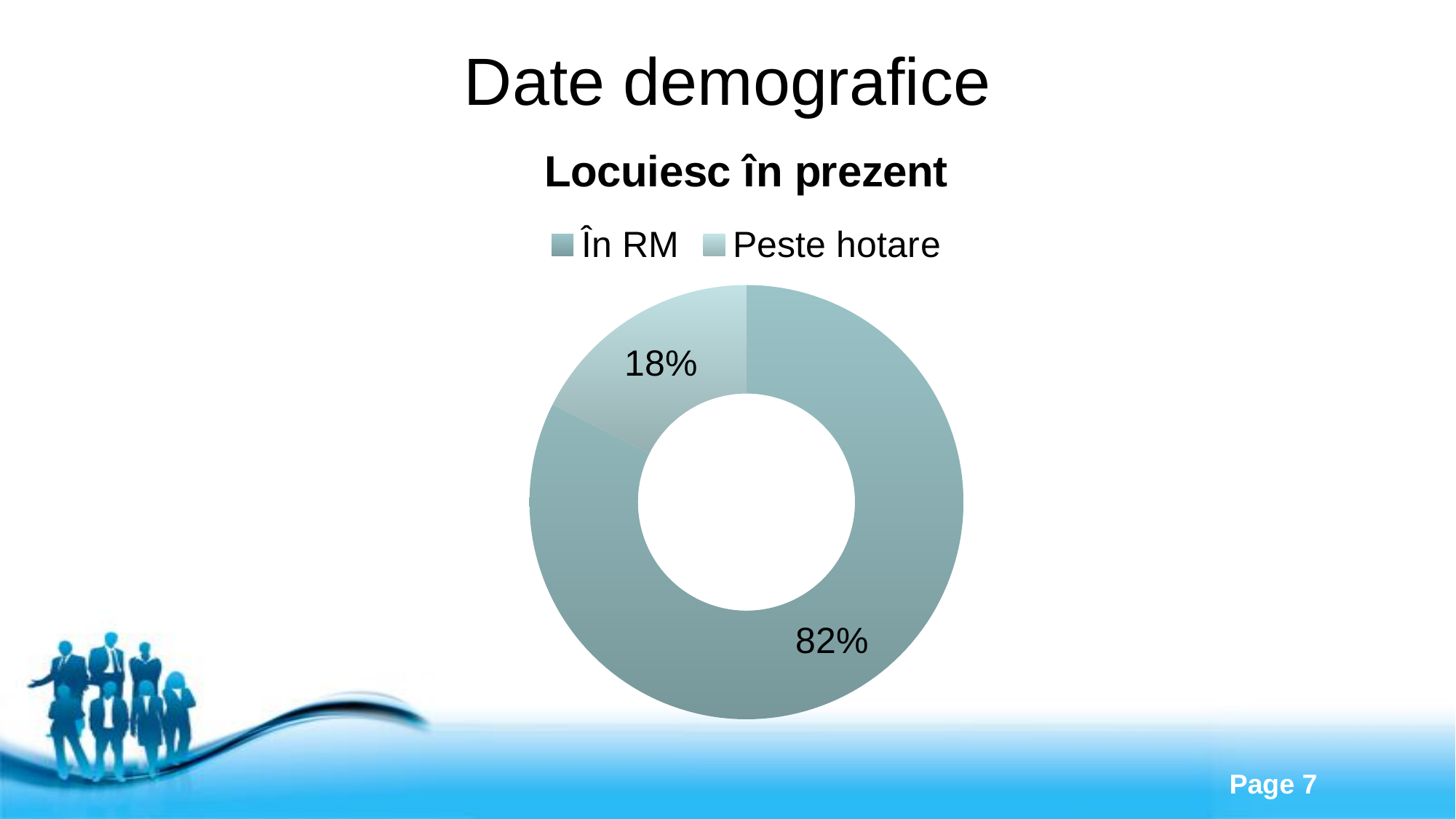
What is the title of the chart? Locuiesc în prezent What are the two legend entries of the chart? În RM, Peste hotare What kind of chart is shown on the slide? Pie chart (doughnut) How many categories are shown in the chart? 2 Which category has the largest slice? În RM What is the total of the two slices shown in the chart? 100% What is the difference in percentage points between the "În RM" and "Peste hotare" slices? 64 What share of the chart does the "În RM" slice represent? 82% What share of the chart does the "Peste hotare" slice represent? 18% Which category has the smallest slice? Peste hotare Which is larger, the "În RM" slice or the "Peste hotare" slice? În RM